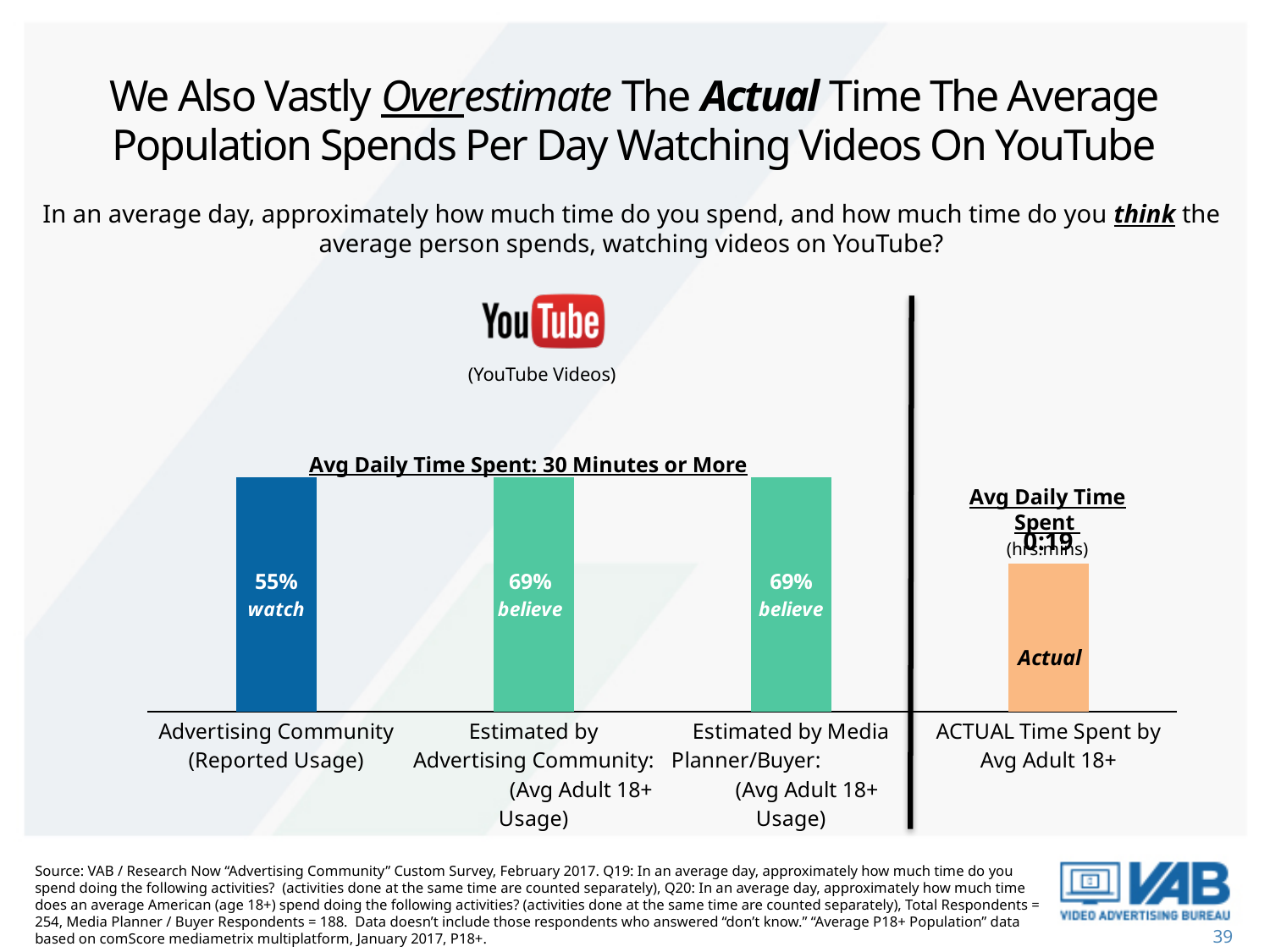
In what unit is the actual average daily time spent expressed? hrs:mins Which is larger: the percentage of the Advertising Community that reports watching 30+ minutes, or the percentage that believes the average adult does? The percentage that believes the average adult does (69%) What type of chart is shown on the slide? Bar chart How many bars are shown in the chart? 4 What is the heading above the three percentage bars? Avg Daily Time Spent: 30 Minutes or More What percentage of the Advertising Community believes the average adult 18+ spends 30 minutes or more per day watching YouTube videos? 69% Which bar shows the lowest percentage among the three percentage bars? Advertising Community (Reported Usage), 55% Is the percentage of the Advertising Community reporting 30+ minutes of daily YouTube viewing greater or less than 50%? greater What percentage of the Advertising Community reports watching YouTube videos for 30 minutes or more per day? 55% What is the actual average daily time spent watching YouTube videos by the average adult 18+, as shown on the slide? 0:19 What is the difference in percentage points between the Advertising Community's estimate for the average adult (69%) and its own reported usage (55%)? 14 percentage points What percentage of Media Planners/Buyers believe the average adult 18+ spends 30 minutes or more per day watching YouTube videos? 69%